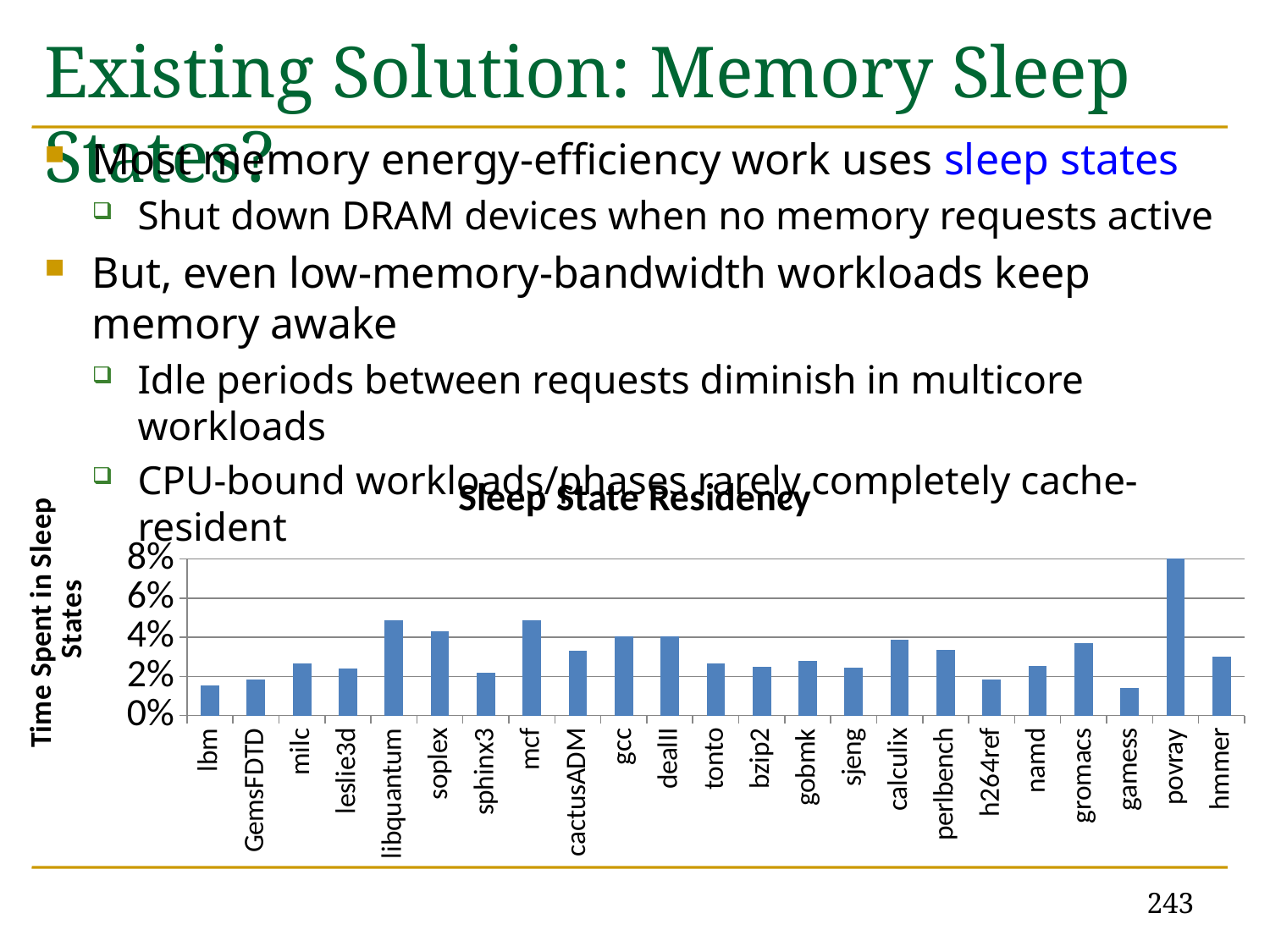
What type of chart is shown on the slide? bar chart Is the value for lbm greater or less than 2%? less What is the title of the chart? Sleep State Residency Which has a higher value, mcf or tonto? mcf Is the value for povray greater or less than 6%? greater Is the value for libquantum greater or less than 4%? greater Which workload has the highest time spent in sleep states? povray How many workloads (categories) are plotted in the chart? 23 What is the label of the vertical axis of the chart? Time Spent in Sleep States Which has a higher value, povray or hmmer? povray